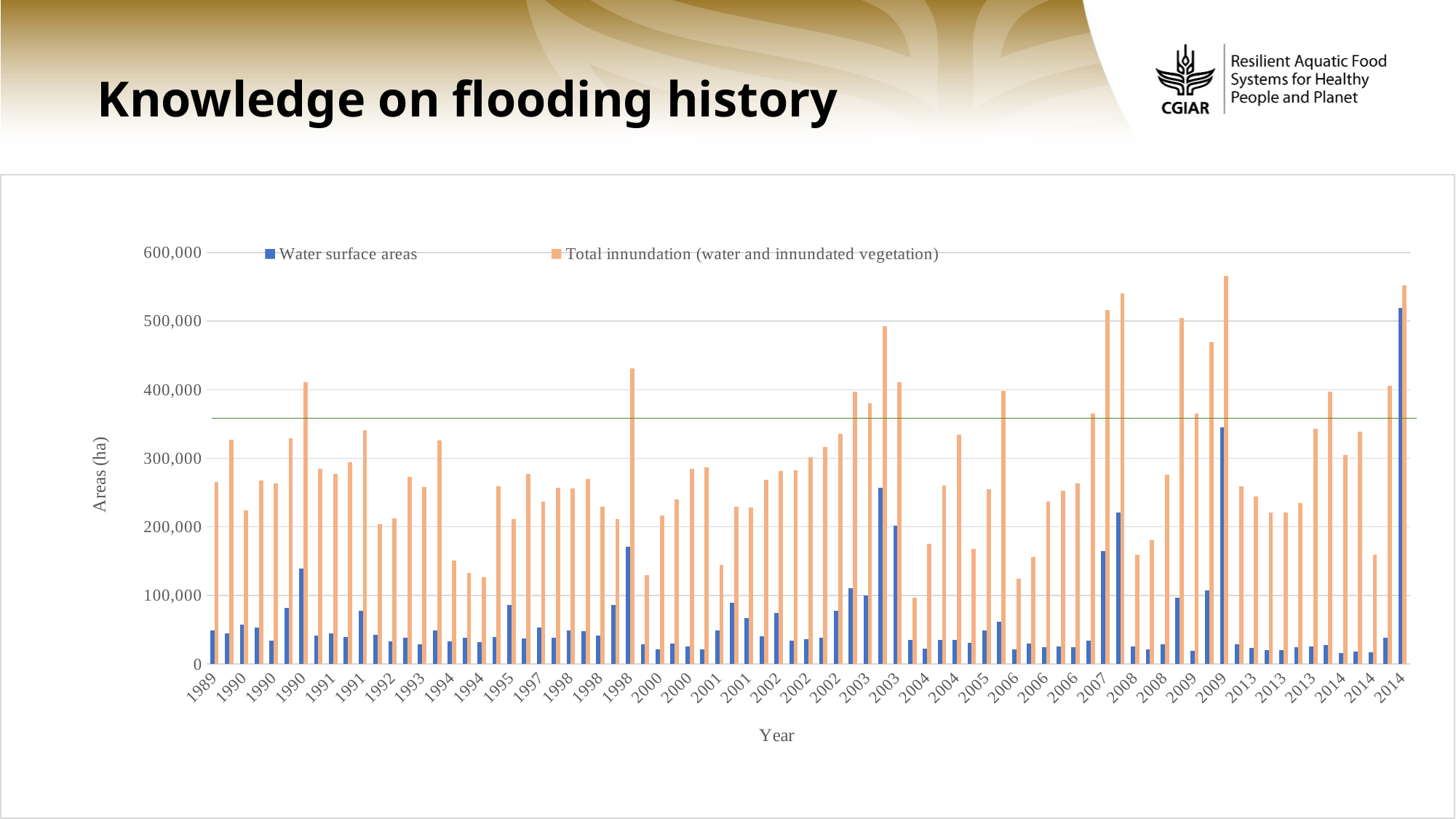
What are the two series named in the chart's legend? Water surface areas; Total innundation (water and innundated vegetation) What kind of chart is shown on the slide? Bar chart Is the Total innundation value for 1989 greater or less than 200,000? greater Is the Water surface areas value for 1989 greater or less than 100,000? less For 2005, which is larger: Water surface areas or Total innundation? Total innundation Which year has the highest Water surface areas bar? 2014 What is the title of the vertical axis of the chart? Areas (ha) How many series does the chart's legend list? 2 Is the Water surface areas value for 1995 greater or less than 100,000? less For 1997, which is larger: Water surface areas or Total innundation? Total innundation